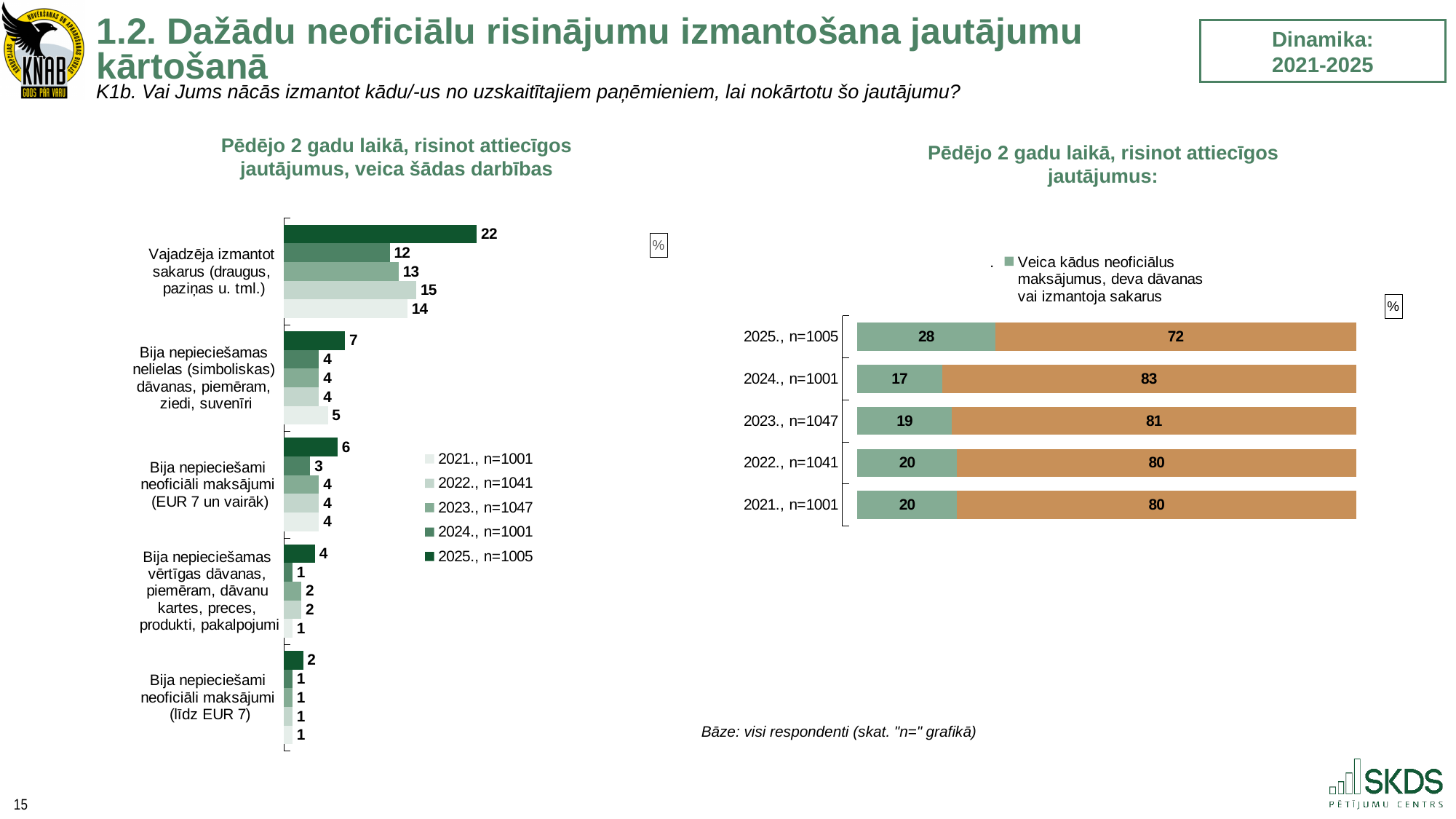
In the left chart, which category has the highest 2025 value? Vajadzēja izmantot sakarus (draugus, paziņas u. tml.) In the left chart, what is the difference between the 2025 and 2024 values for "Vajadzēja izmantot sakarus (draugus, paziņas u. tml.)"? 10 In the right chart, what is the value of the orange segment for "2024., n=1001"? 83 How many series does the legend of the left chart list? 5 In the left chart, what is the 2022 value for "Vajadzēja izmantot sakarus (draugus, paziņas u. tml.)"? 15 How many categories are shown in the left chart? 5 In the left chart, what is the 2024 value for "Bija nepieciešami neoficiāli maksājumi (EUR 7 un vairāk)"? 3 In the right chart, which year has the lowest green segment value? 2024., n=1001 In the right chart ("Pēdējo 2 gadu laikā, risinot attiecīgos jautājumus:"), what is the value of the green segment for "2025., n=1005"? 28 In the left chart ("Pēdējo 2 gadu laikā, risinot attiecīgos jautājumus, veica šādas darbības"), what is the 2025 value for "Vajadzēja izmantot sakarus (draugus, paziņas u. tml.)"? 22 What type of chart is the right chart? Stacked bar chart In the left chart, what is the 2025 value for "Bija nepieciešamas nelielas (simboliskas) dāvanas, piemēram, ziedi, suvenīri"? 7